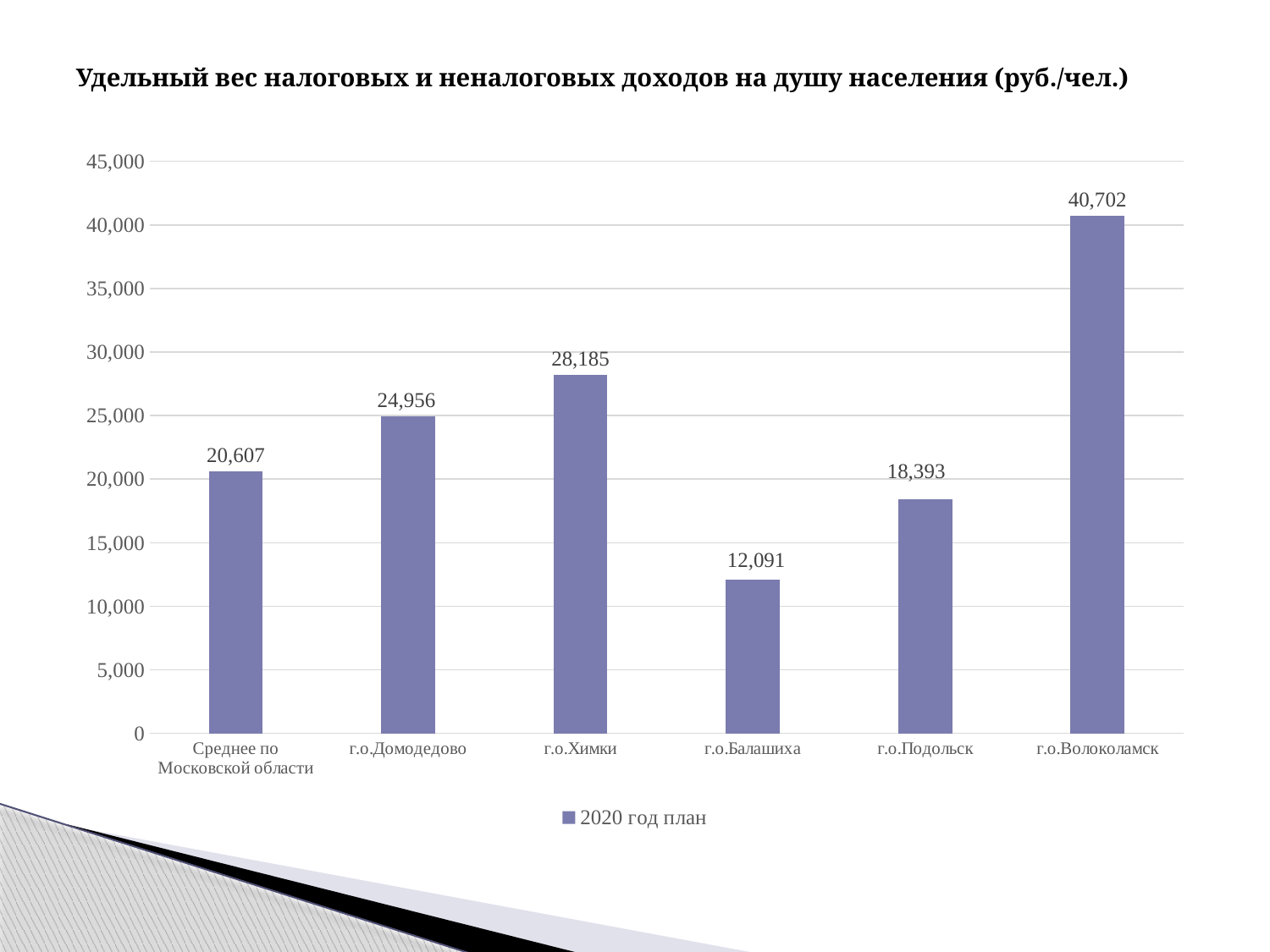
What is the value for г.о.Домодедово? 24,956 Is the value for г.о.Подольск greater or less than 20,000? less What is the difference between the values for г.о.Волоколамск and г.о.Химки? 12,517 Which is larger, the value for г.о.Химки or the value for г.о.Домодедово? г.о.Химки What is the difference between the values for г.о.Подольск and г.о.Балашиха? 6,302 How many categories are shown on the x axis? 6 What is the value for г.о.Балашиха? 12,091 Which category has the lowest value? г.о.Балашиха Which category has the highest value? г.о.Волоколамск What is the value for Среднее по Московской области? 20,607 How many series does the legend list? 1 What kind of chart is shown on the slide? bar chart